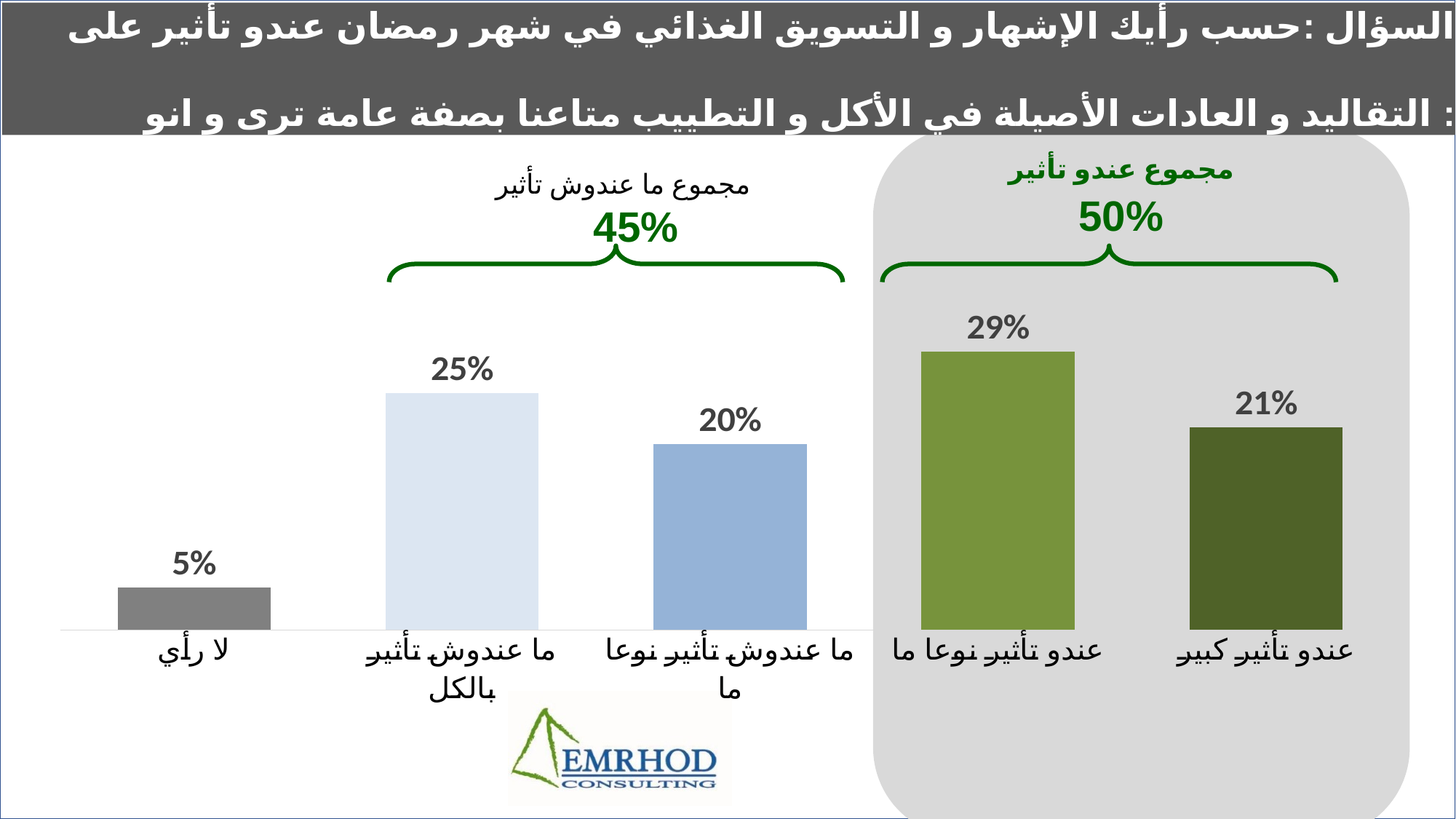
Which category has the lowest value? لا رأي What kind of chart is shown on the slide? bar chart Which is larger, "ما عندوش تأثير بالكل" or "ما عندوش تأثير نوعا ما"? ما عندوش تأثير بالكل What is the value for "عندو تأثير كبير"? 21% What is the difference between "عندو تأثير نوعا ما" and "عندو تأثير كبير"? 8% What total is shown for the group labelled "مجموع عندو تأثير"? 50% What is the value for "عندو تأثير نوعا ما"? 29% Which category has the highest value? عندو تأثير نوعا ما What is the value for "ما عندوش تأثير بالكل"? 25% How many categories are shown in the chart? 5 What total is shown for the group labelled "مجموع ما عندوش تأثير"? 45% What is the value for "لا رأي"? 5%